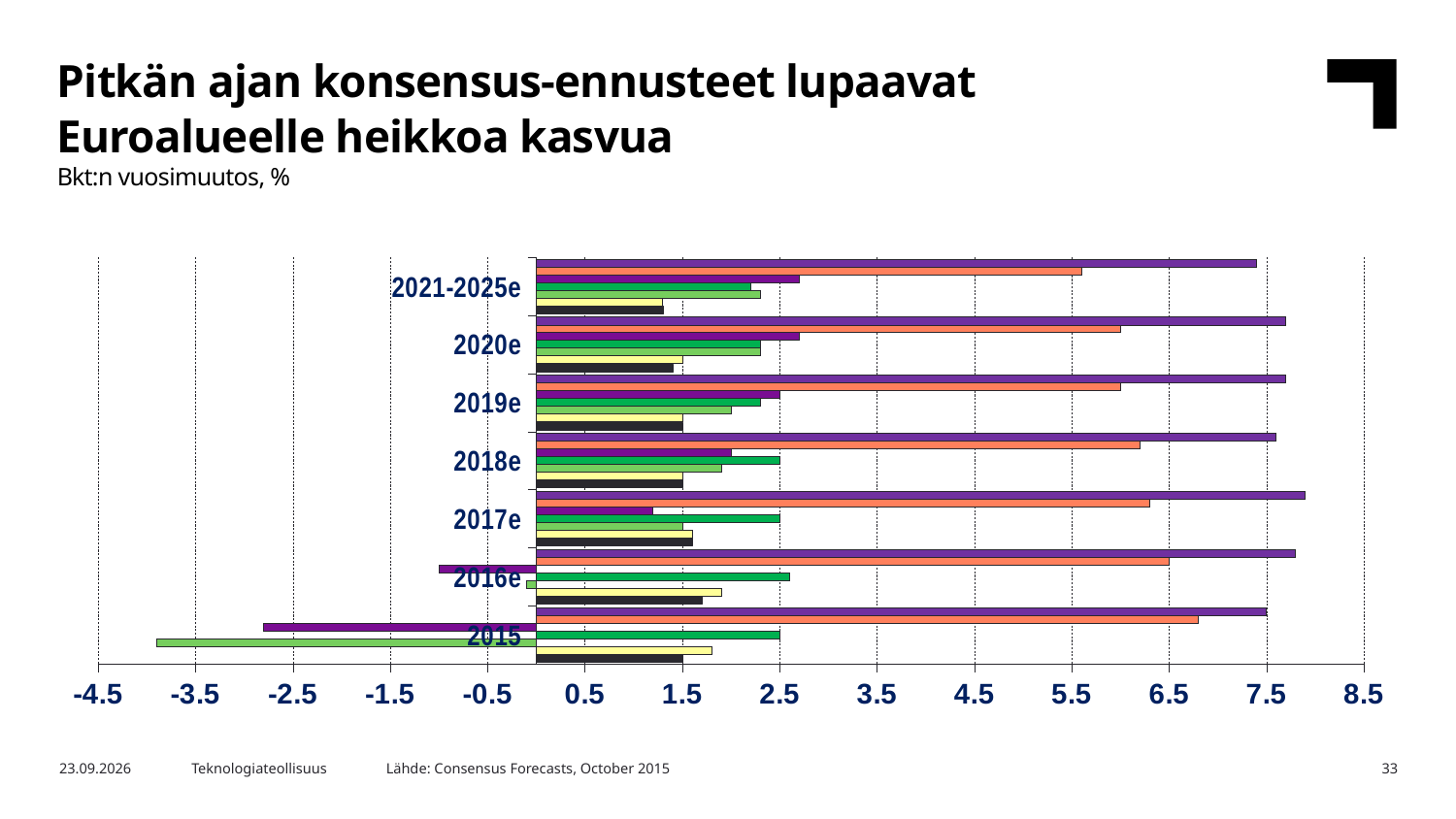
For 2015, which is larger: the dark purple bar or the orange bar? the dark purple bar What kind of chart is shown on the slide? bar chart How many bars are plotted for each year category? 7 Is the value of the magenta bar for 2016e greater or less than -0.5? less Which year category has the lowest value for the light green bar? 2015 Is the value of the dark purple bar for 2015 greater or less than 6.5? greater Is the value of the dark purple bar for 2017e greater or less than 6.5? greater How many year categories are shown on the chart? 7 What unit does the subtitle say the chart values are in? Bkt:n vuosimuutos, %